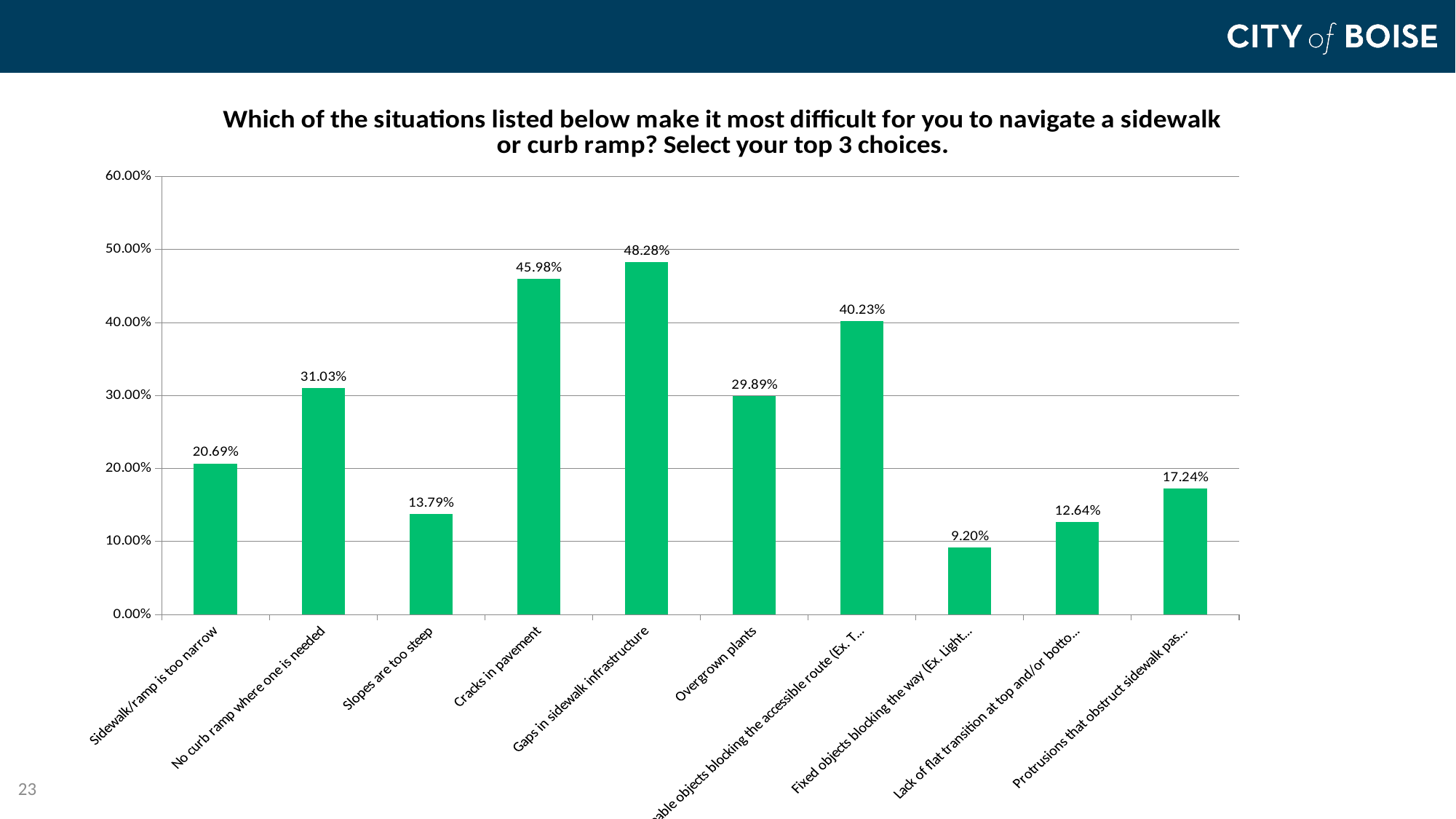
What is the highest value shown on the vertical axis? 60.00% What percentage of respondents selected "Cracks in pavement"? 45.98% What is the value for "Slopes are too steep"? 13.79% What is the value for "Overgrown plants"? 29.89% Is the value for "Overgrown plants" greater or less than 30.00%? less How many situations (bars) are shown in the chart? 10 What is the difference between the values for "Gaps in sidewalk infrastructure" and "Cracks in pavement"? 2.30% Which situation has the lowest percentage? Fixed objects blocking the way Which situation has the highest percentage? Gaps in sidewalk infrastructure What kind of chart is shown on the slide? Bar chart Which is larger: the value for "Sidewalk/ramp is too narrow" or the value for "Slopes are too steep"? Sidewalk/ramp is too narrow What is the value for "No curb ramp where one is needed"? 31.03%